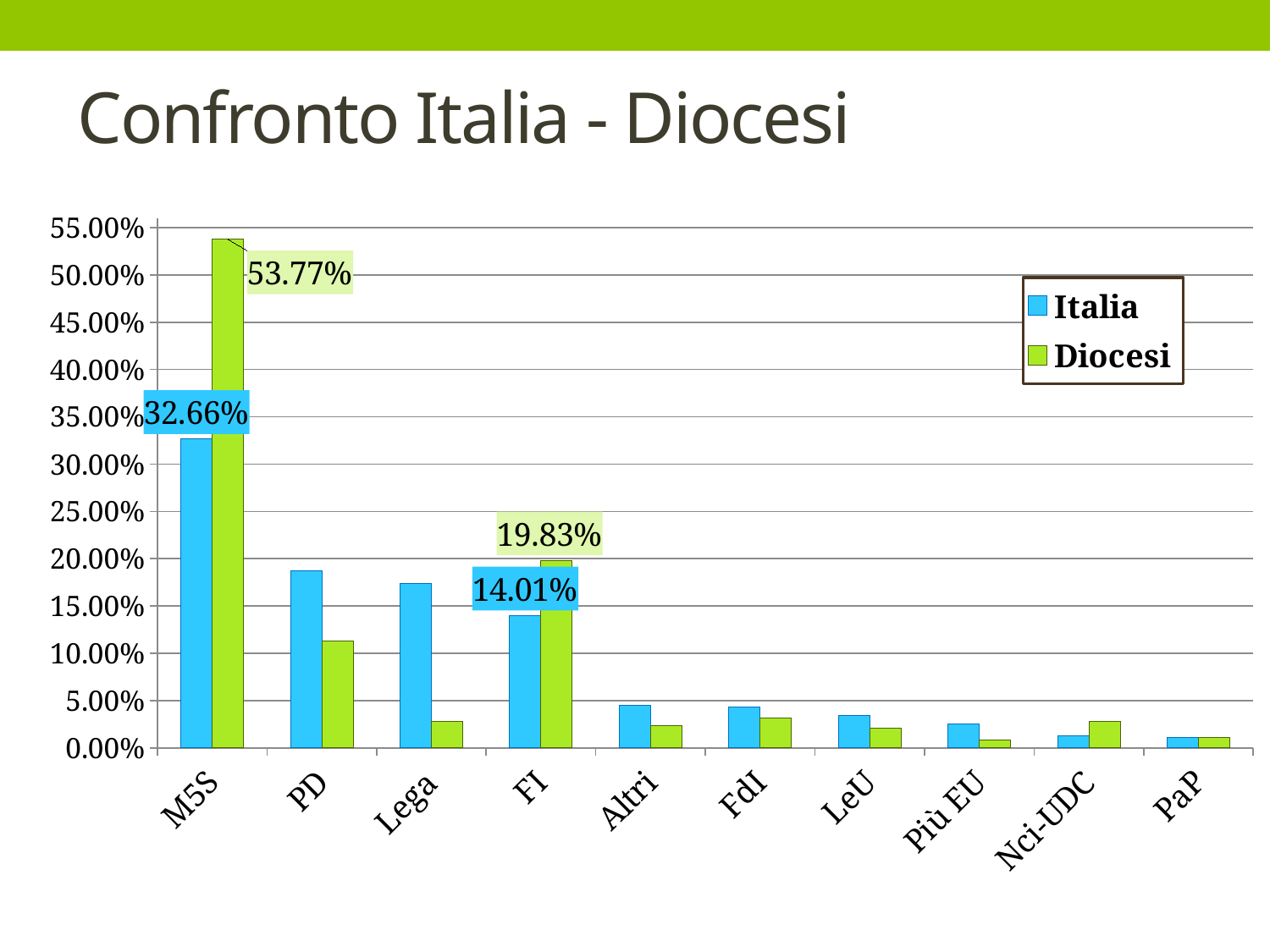
Is the Italia value for Lega greater or less than 15.00%? greater What is the Italia value for M5S? 32.66% What type of chart is shown on the slide? Bar chart What is the Italia value for FI? 14.01% How many series does the legend list? 2 What is the Diocesi value for M5S? 53.77% For PD, which series has the larger value, Italia or Diocesi? Italia What is the Diocesi value for FI? 19.83% Which category has the highest Diocesi value? M5S What is the difference between the Diocesi and Italia values for M5S? 21.11% How many categories are shown on the x axis? 10 Is the Diocesi value for Lega greater or less than 5.00%? less